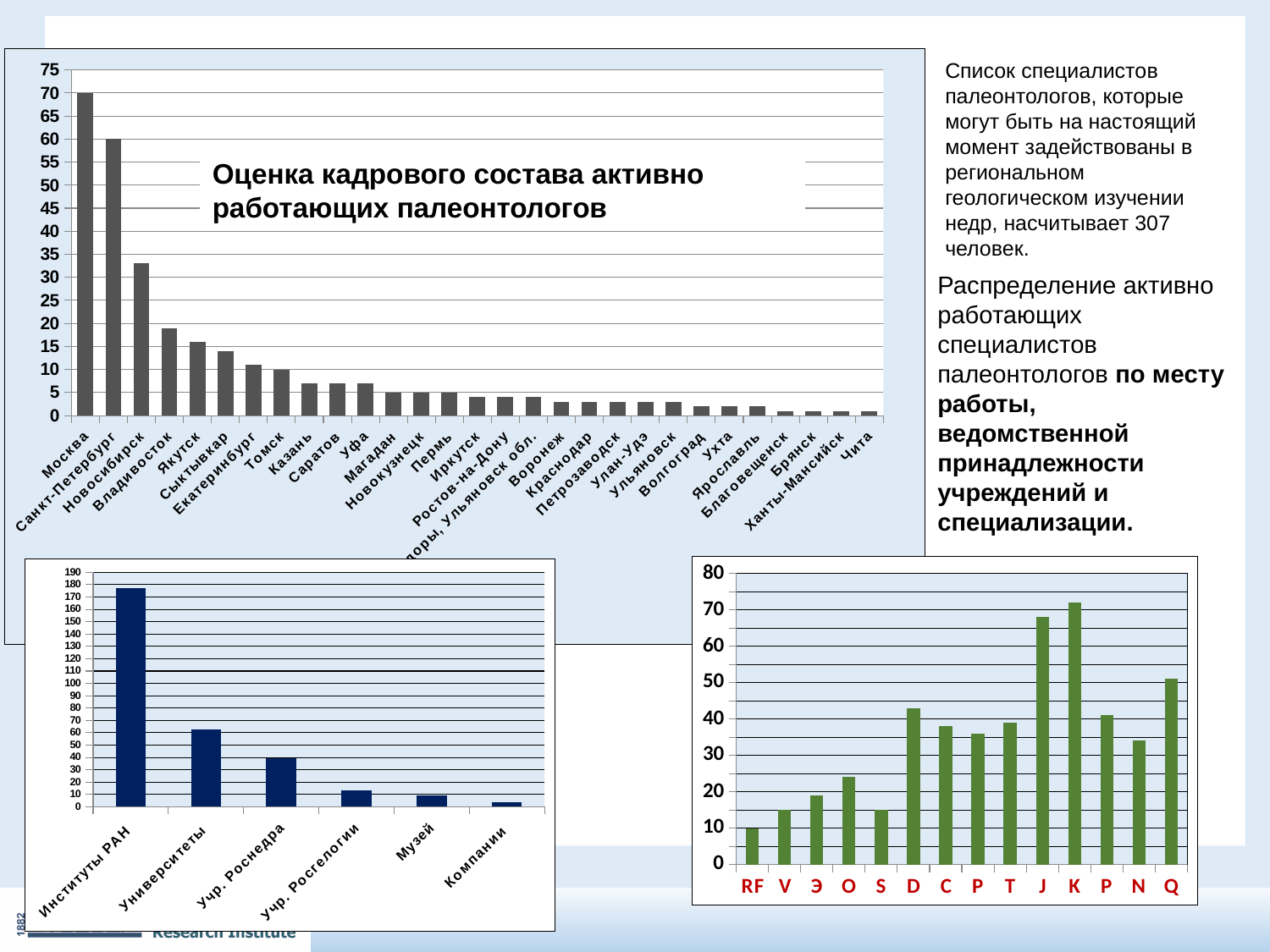
In the top chart 'Оценка кадрового состава активно работающих палеонтологов', what is the value for Москва? 70 In the top chart 'Оценка кадрового состава активно работающих палеонтологов', what is the value for Санкт-Петербург? 60 In the top chart 'Оценка кадрового состава активно работающих палеонтологов', is the value for Новосибирск greater or less than 30? greater In the bottom-right chart with green bars, how many categories are shown on the x axis? 14 In the bottom-left chart, how many categories are shown on the x axis? 6 In the bottom-left chart, which category has the highest value? Институты РАН In the top chart 'Оценка кадрового состава активно работающих палеонтологов', which city has the highest value? Москва In the bottom-right chart with green bars, which category has the highest value? K In the bottom-left chart, is the value for Университеты greater or less than 50? greater In the top chart 'Оценка кадрового состава активно работающих палеонтологов', do the values rise or fall from left to right along the x axis? fall In the bottom-right chart with green bars, is the value for J greater or less than 60? greater What kind of chart is the top chart titled 'Оценка кадрового состава активно работающих палеонтологов'? bar chart